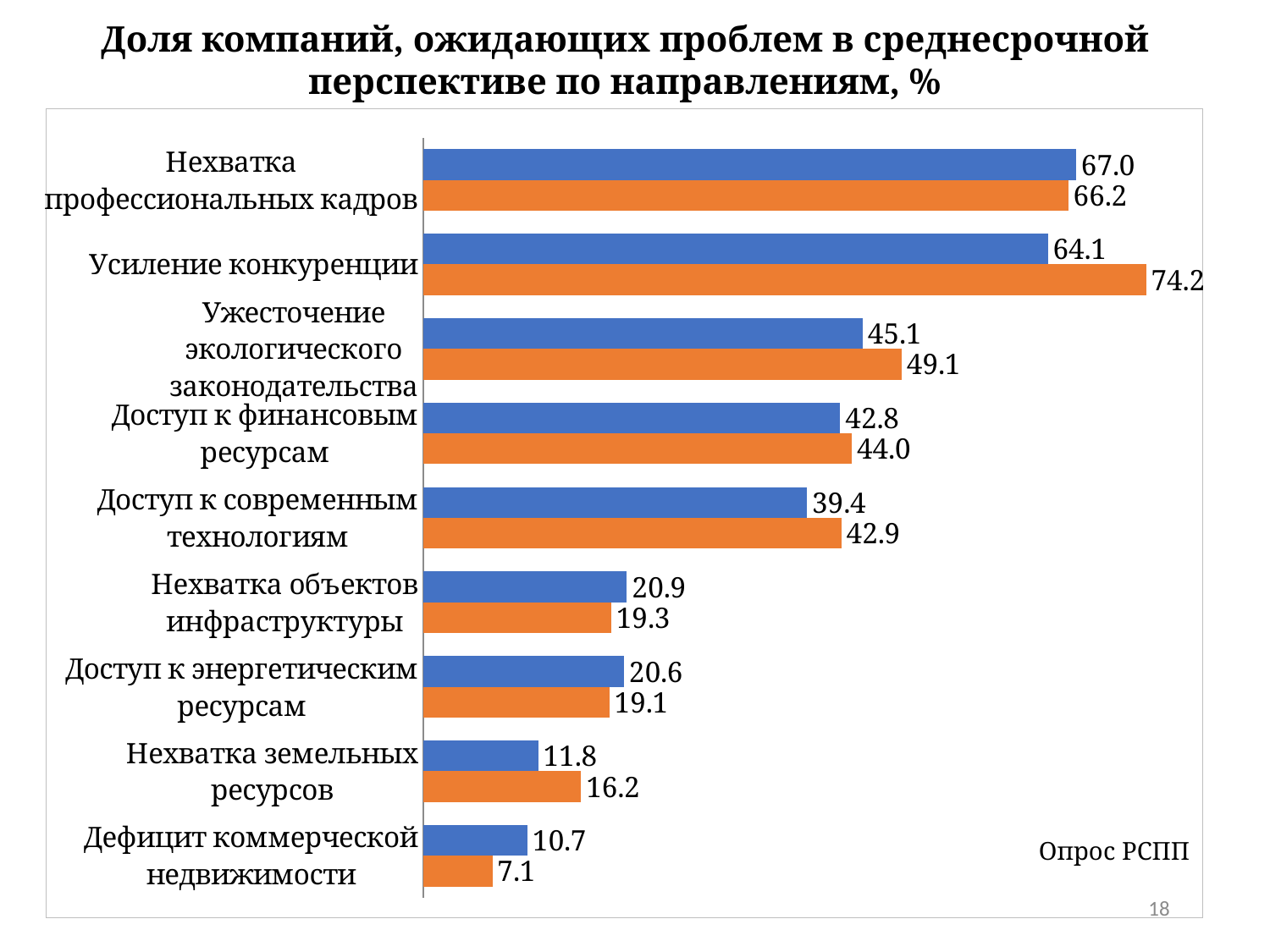
What is the value of the blue bar for «Нехватка профессиональных кадров»? 67.0 What is the value of the orange bar for «Дефицит коммерческой недвижимости»? 7.1 What is the difference between the orange and blue bar values for «Усиление конкуренции»? 10.1 How many categories are shown on the chart? 9 What is the source noted on the chart? Опрос РСПП What is the value of the blue bar for «Доступ к современным технологиям»? 39.4 Which category has the highest blue bar value? Нехватка профессиональных кадров For «Ужесточение экологического законодательства», which bar is larger, blue or orange? orange What is the value of the orange bar for «Усиление конкуренции»? 74.2 What type of chart is shown on the slide? bar chart Which category has the lowest orange bar value? Дефицит коммерческой недвижимости What is the difference between the orange and blue bar values for «Нехватка земельных ресурсов»? 4.4